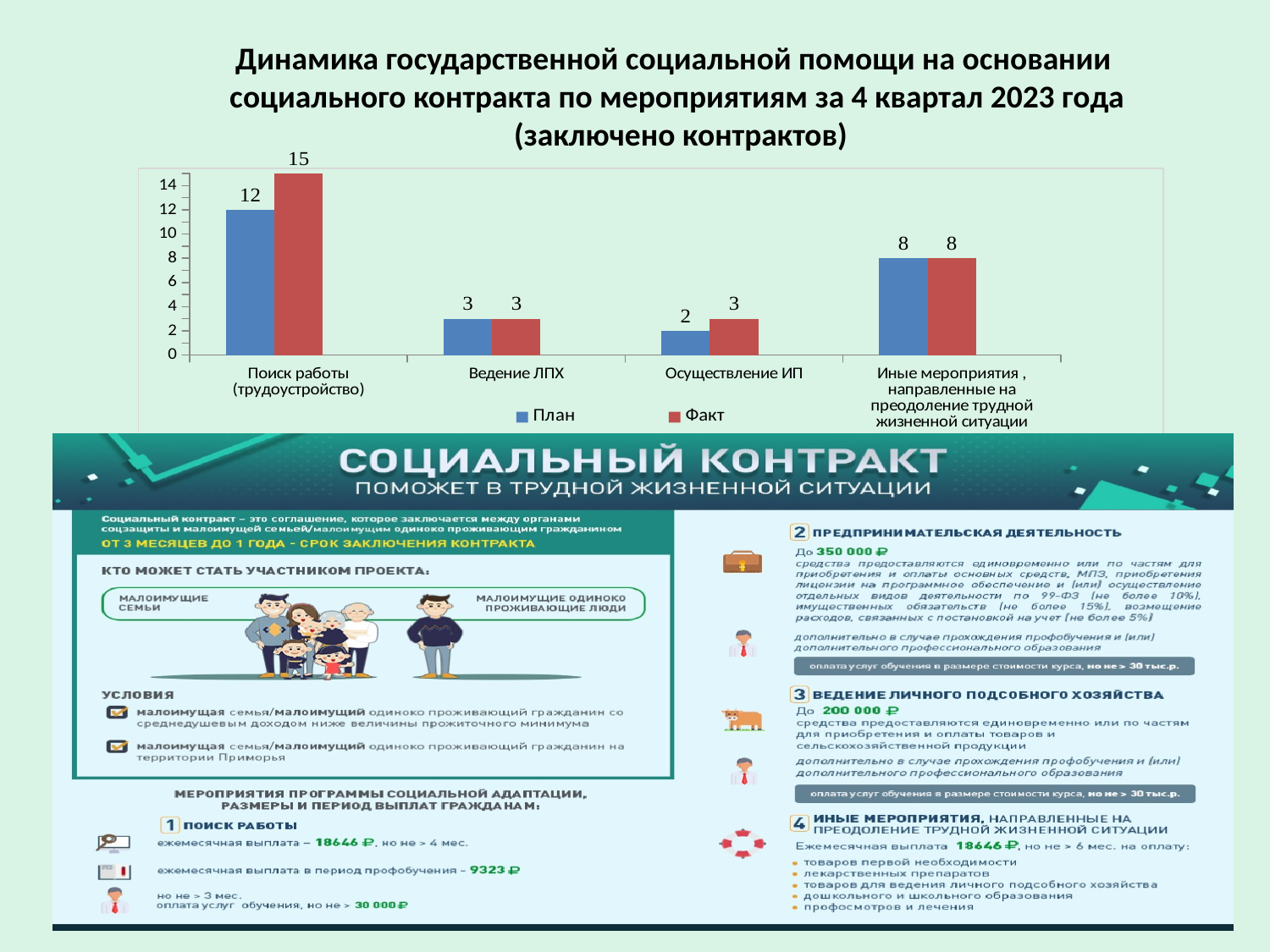
What is the План value for Осуществление ИП? 2 What is the Факт value for Поиск работы (трудоустройство)? 15 What is the План value for Поиск работы (трудоустройство)? 12 How many categories are shown on the x axis? 4 Which is larger for Осуществление ИП, the План value or the Факт value? Факт How many series does the legend list? 2 What is the Факт value for Иные мероприятия, направленные на преодоление трудной жизненной ситуации? 8 Which colour represents the Факт series? Red Which category has the highest Факт value? Поиск работы (трудоустройство) Which category has the lowest План value? Осуществление ИП What is the difference between the Факт and План values for Поиск работы (трудоустройство)? 3 What kind of chart is shown on the slide? Bar chart